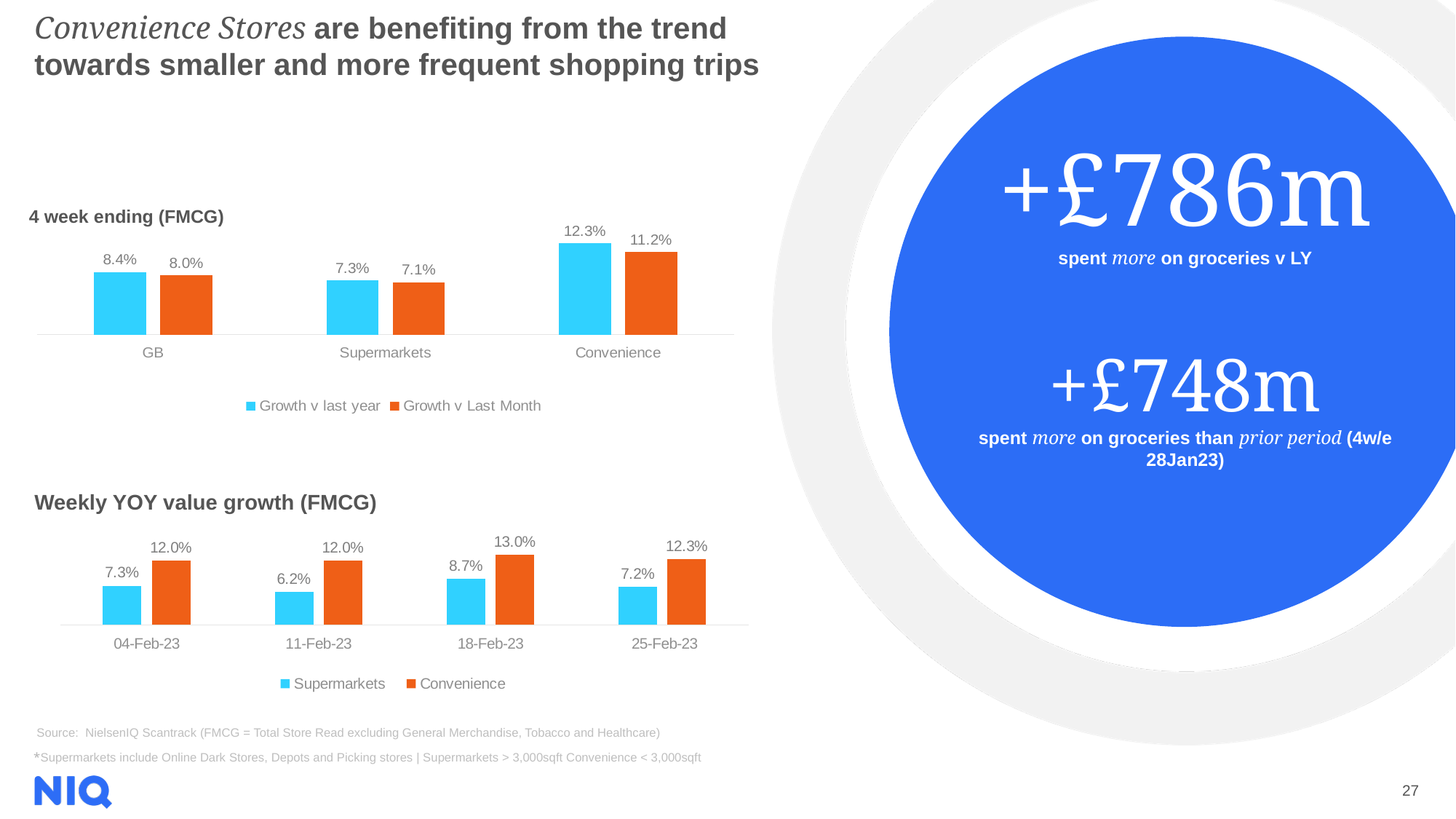
In the 'Weekly YOY value growth (FMCG)' chart, which week has the lowest Supermarkets value? 11-Feb-23 In the '4 week ending (FMCG)' chart, what is the Growth v Last Month value for GB? 8.0% In the '4 week ending (FMCG)' chart, what is the Growth v last year value for Convenience? 12.3% In the 'Weekly YOY value growth (FMCG)' chart, which is larger for 25-Feb-23: Supermarkets or Convenience? Convenience How many weeks are shown on the x axis of the 'Weekly YOY value growth (FMCG)' chart? 4 In the 'Weekly YOY value growth (FMCG)' chart, what is the Supermarkets value for 11-Feb-23? 6.2% In the '4 week ending (FMCG)' chart, which category has the lowest Growth v Last Month? Supermarkets In the '4 week ending (FMCG)' chart, what is the difference between Growth v last year and Growth v Last Month for Convenience? 1.1% What kind of chart is the 'Weekly YOY value growth (FMCG)' chart? Bar chart How many series does the legend of the '4 week ending (FMCG)' chart list? 2 In the 'Weekly YOY value growth (FMCG)' chart, what is the Convenience value for 18-Feb-23? 13.0% In the '4 week ending (FMCG)' chart, which category has the highest Growth v last year? Convenience